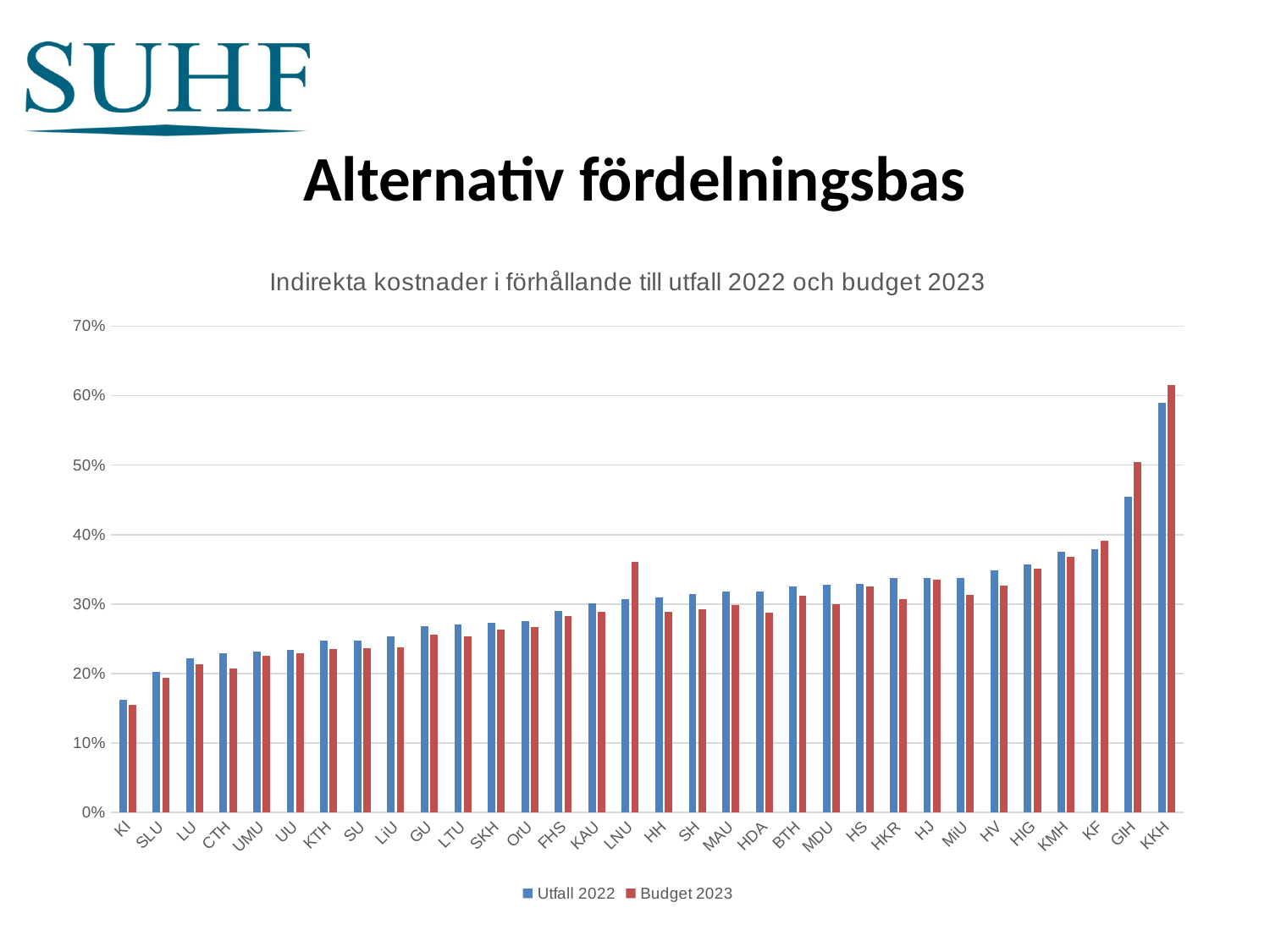
Which institution has the lowest Budget 2023 value? KI What kind of chart is shown on the slide? bar chart Is the Utfall 2022 value for KKH greater or less than 50%? greater Is the Utfall 2022 value for KI greater or less than 20%? less Which institution has the highest Utfall 2022 value? KKH Do the Utfall 2022 values generally rise or fall from left to right along the x axis? rise How many series does the legend list? 2 For HKR, which is larger: Utfall 2022 or Budget 2023? Utfall 2022 Is the Budget 2023 value for LNU greater or less than 30%? greater How many institutions (categories) are shown on the x axis? 32 For LNU, which is larger: Utfall 2022 or Budget 2023? Budget 2023